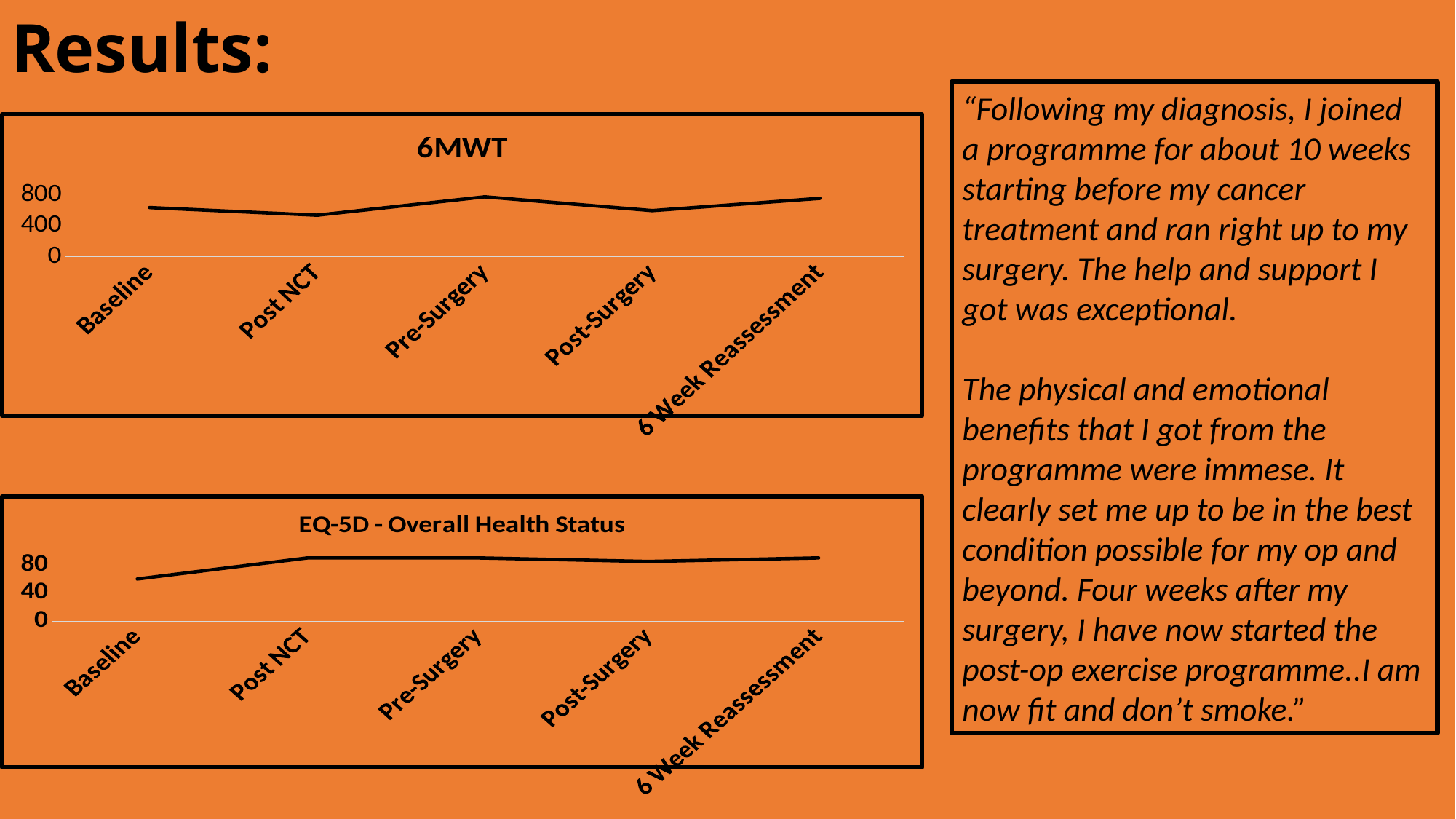
On the 6MWT chart, which is larger, the value for Post NCT or the value for Pre-Surgery? Pre-Surgery How many time points are plotted on the EQ-5D - Overall Health Status chart? 5 How many time points are plotted on the 6MWT chart? 5 What kind of chart is the EQ-5D - Overall Health Status chart? line chart On the 6MWT chart, is the value for Pre-Surgery greater or less than 400? greater On the 6MWT chart, which time point has the lowest value? Post NCT On the 6MWT chart, is the value for Baseline greater or less than 400? greater On the EQ-5D - Overall Health Status chart, which is larger, the value for Baseline or the value for Post NCT? Post NCT On the EQ-5D - Overall Health Status chart, is the value for Baseline greater or less than 40? greater On the EQ-5D - Overall Health Status chart, which time point has the lowest value? Baseline What is the title of the lower chart on the slide? EQ-5D - Overall Health Status What kind of chart is the 6MWT chart? line chart